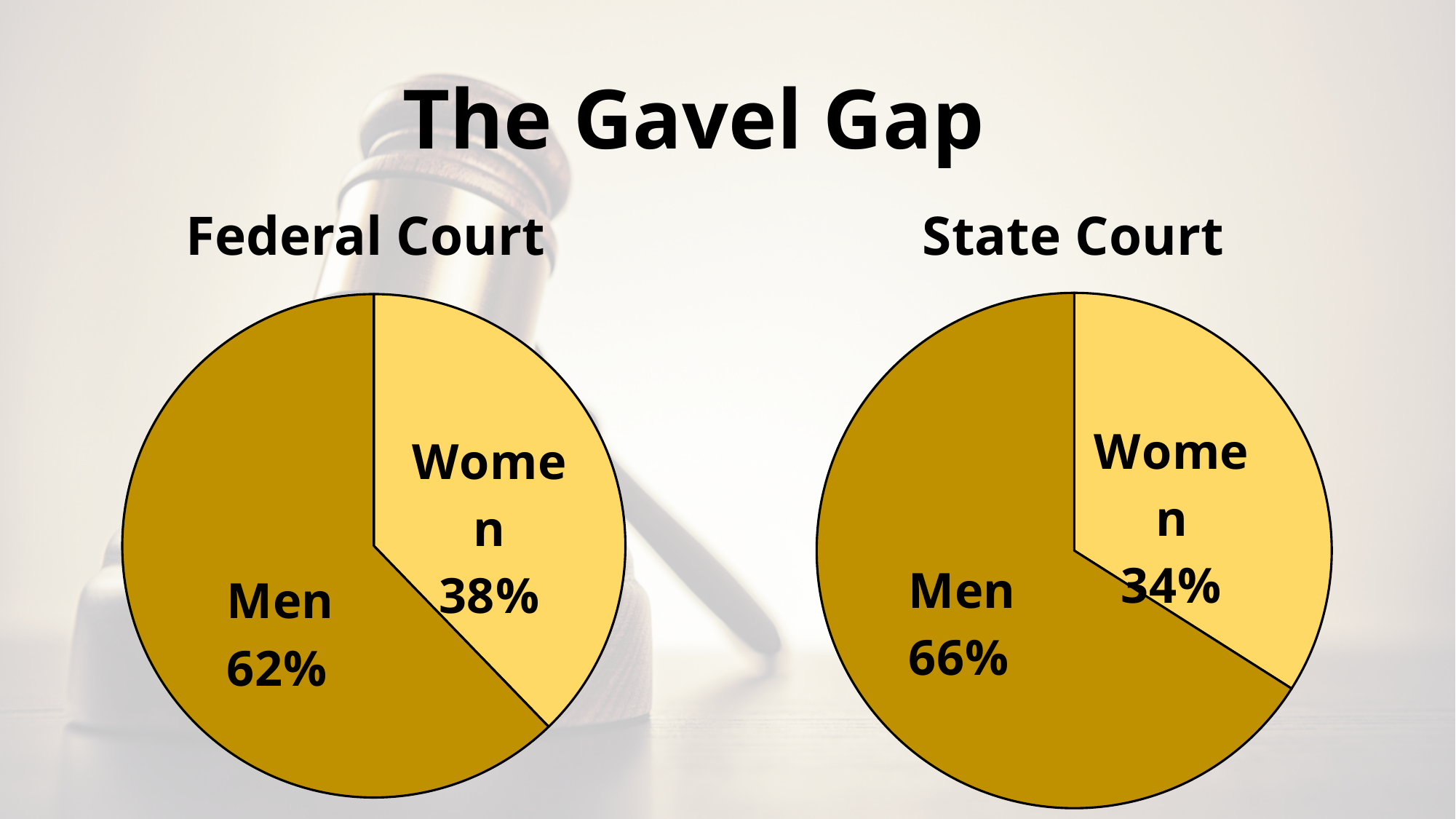
Is the Women share larger in the Federal Court chart or the State Court chart? Federal Court In the State Court chart, which slice is the smallest? Women What kind of chart is the Federal Court chart? Pie chart In the State Court chart, what share of the pie is Women? 34% What is the title of the slide containing the two charts? The Gavel Gap In the Federal Court chart, what share of the pie is Men? 62% How many slices does the State Court chart have? 2 In the State Court chart, what share of the pie is Men? 66% In the Federal Court chart, what share of the pie is Women? 38% In the Federal Court chart, what is the difference between the Men and Women shares? 24% In the Federal Court chart, which slice is the largest? Men In the State Court chart, what is the difference between the Men and Women shares? 32%